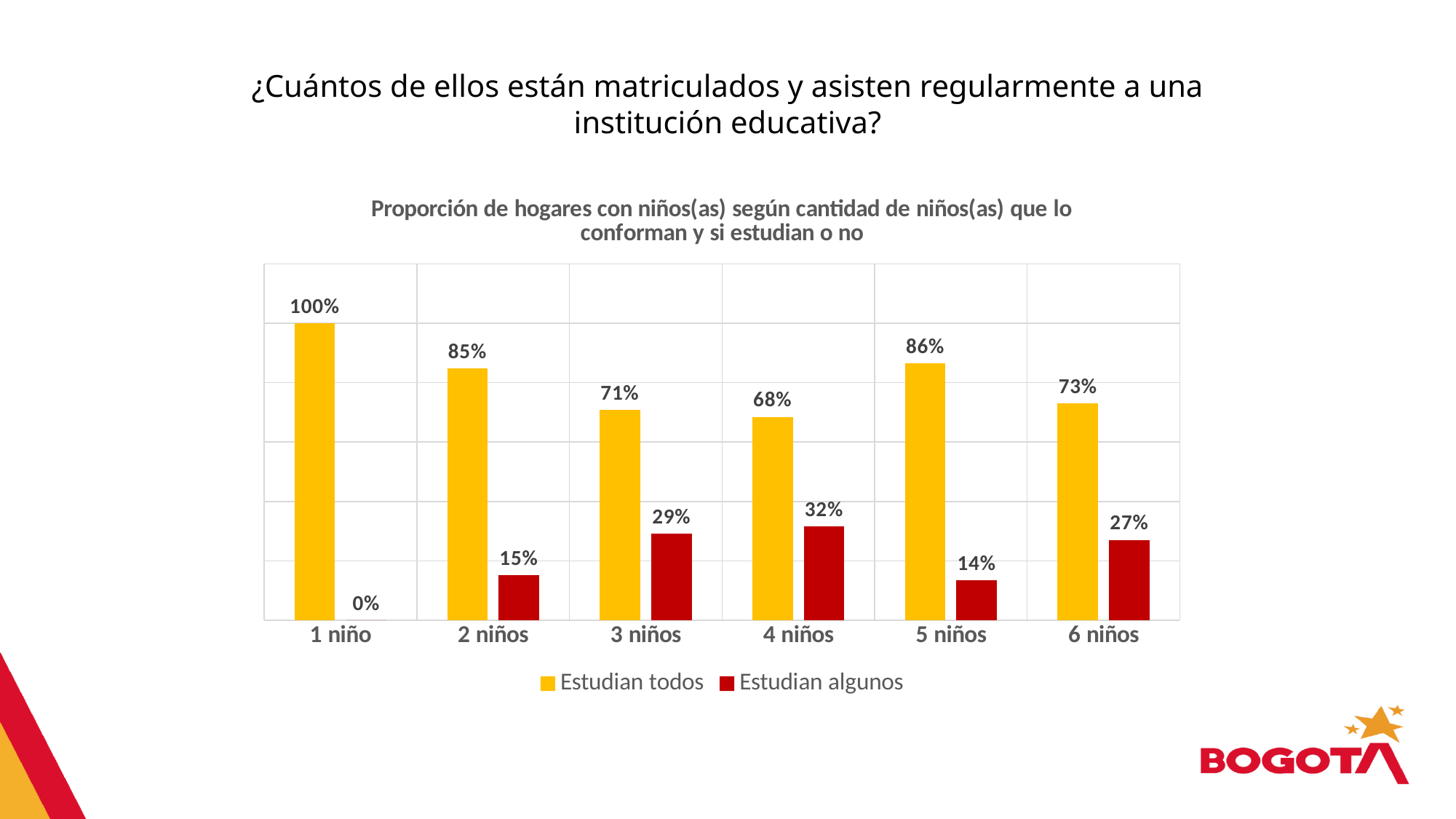
How many series does the legend list? 2 Which category has the highest value for "Estudian todos"? 1 niño What kind of chart is shown on the slide? Bar chart Which is larger: "Estudian algunos" for 3 niños or for 6 niños? 3 niños What is the difference between "Estudian todos" and "Estudian algunos" for 5 niños? 72% Which category has the highest value for "Estudian algunos"? 4 niños Which colour represents the "Estudian algunos" series? Red What is the value of "Estudian algunos" for 1 niño? 0% How many categories are shown on the x axis? 6 Which category has the lowest value for "Estudian todos"? 4 niños What is the value of "Estudian algunos" for 4 niños? 32% What is the value of "Estudian todos" for 3 niños? 71%